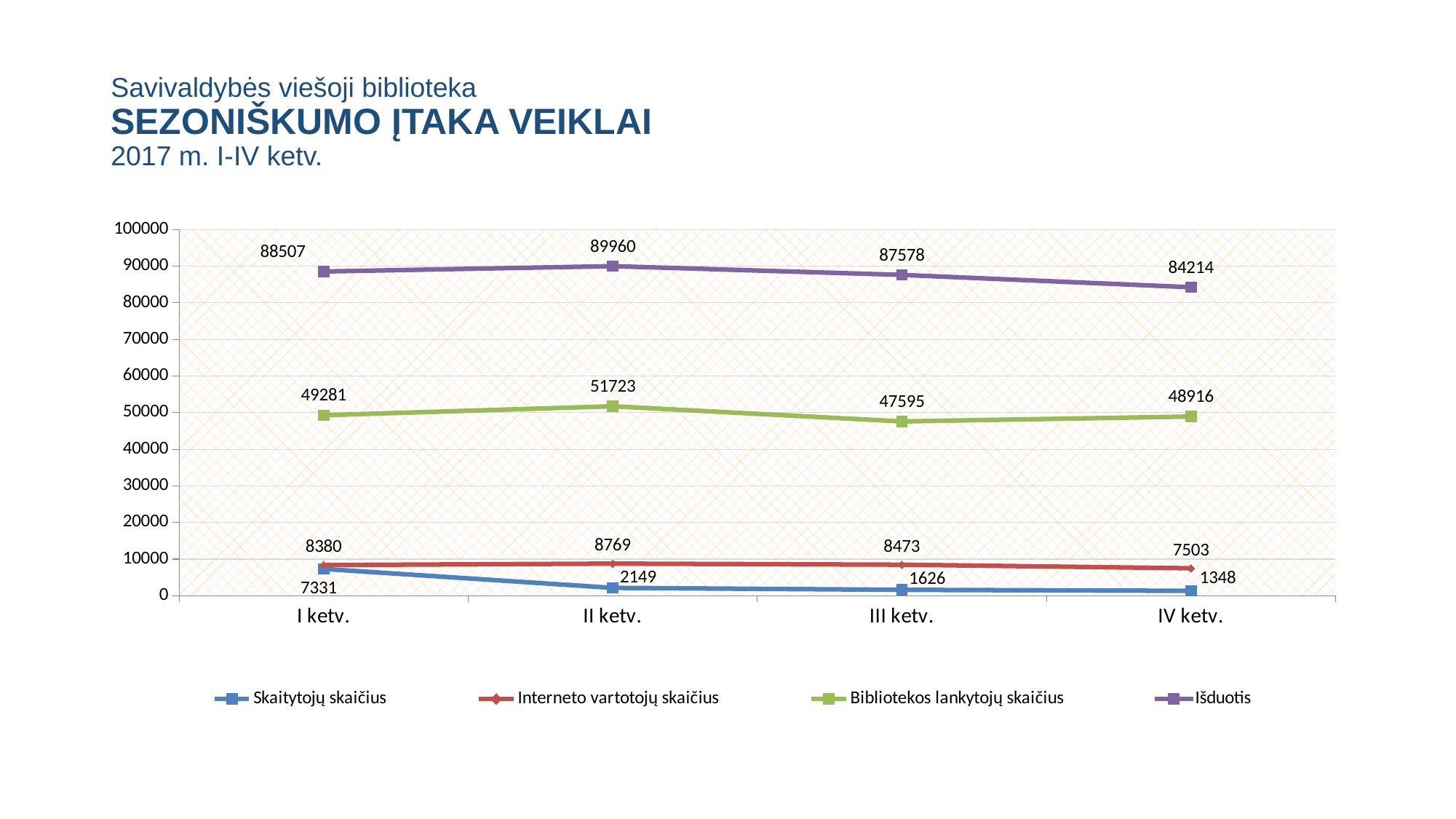
What is the value of Išduotis in II ketv.? 89960 How many quarters (categories) are plotted on the x axis? 4 What is the value of Skaitytojų skaičius in I ketv.? 7331 Which series is shown in purple in the legend? Išduotis In which quarter is Išduotis highest? II ketv. What is the value of Bibliotekos lankytojų skaičius in III ketv.? 47595 What kind of chart is shown on the slide? line chart Which is larger: Interneto vartotojų skaičius in II ketv. or in IV ketv.? II ketv. Does Skaitytojų skaičius rise or fall from I ketv. to IV ketv.? fall What is the difference between Išduotis in II ketv. and IV ketv.? 5746 In which quarter is Skaitytojų skaičius lowest? IV ketv. How many series does the legend list? 4